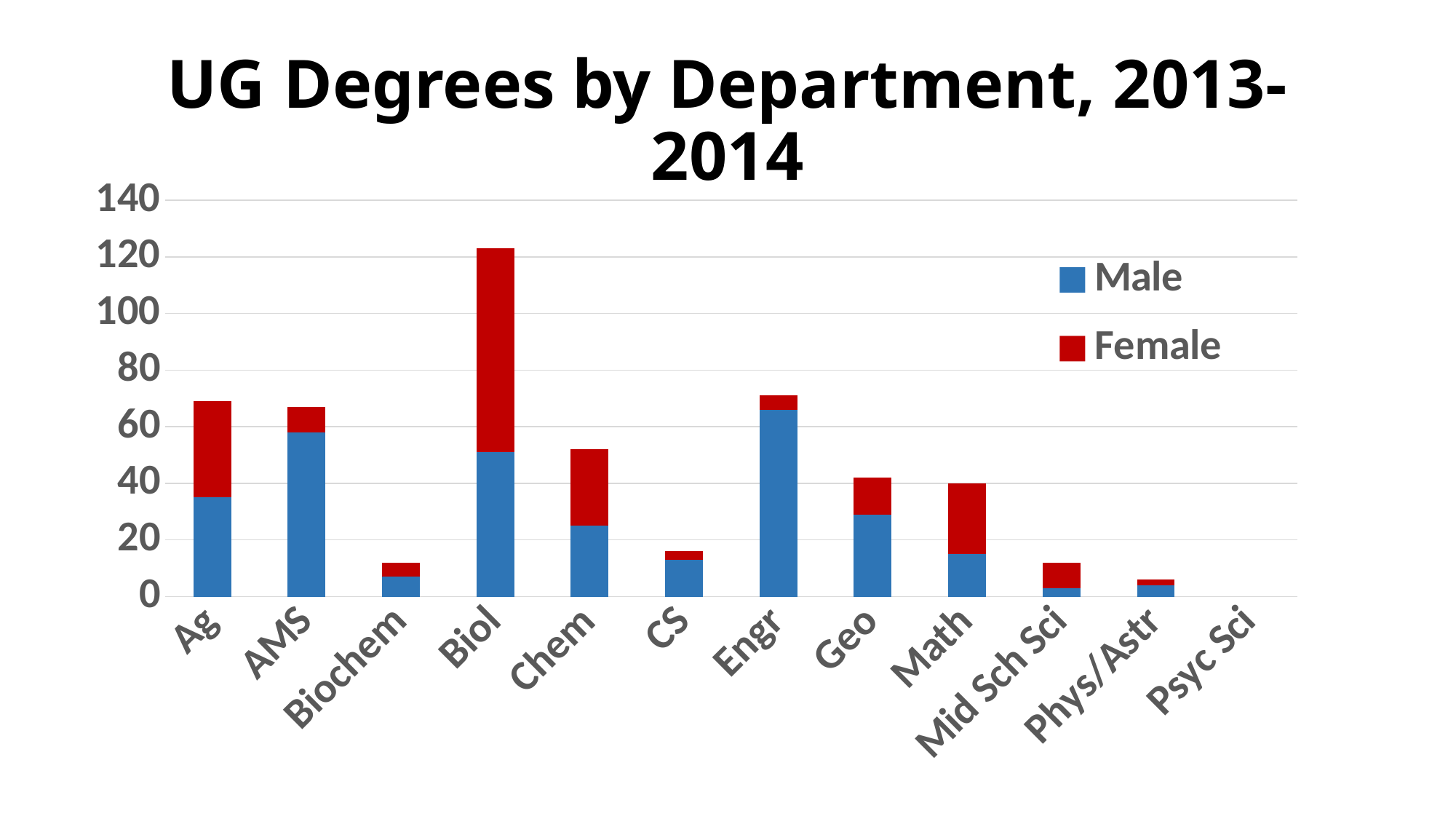
Is the Male value for AMS greater or less than 40? greater How many series does the legend list? 2 How many departments are shown on the x axis? 12 Is the Male value for Ag greater or less than 40? less Is the total bar for Biochem greater or less than 20? less Which colour represents Female in the legend? Red Which has the larger Female segment, Math or Engr? Math Which department has the tallest bar? Biol Which has the larger total bar, Chem or Geo? Chem What kind of chart is shown on the slide? Stacked bar chart